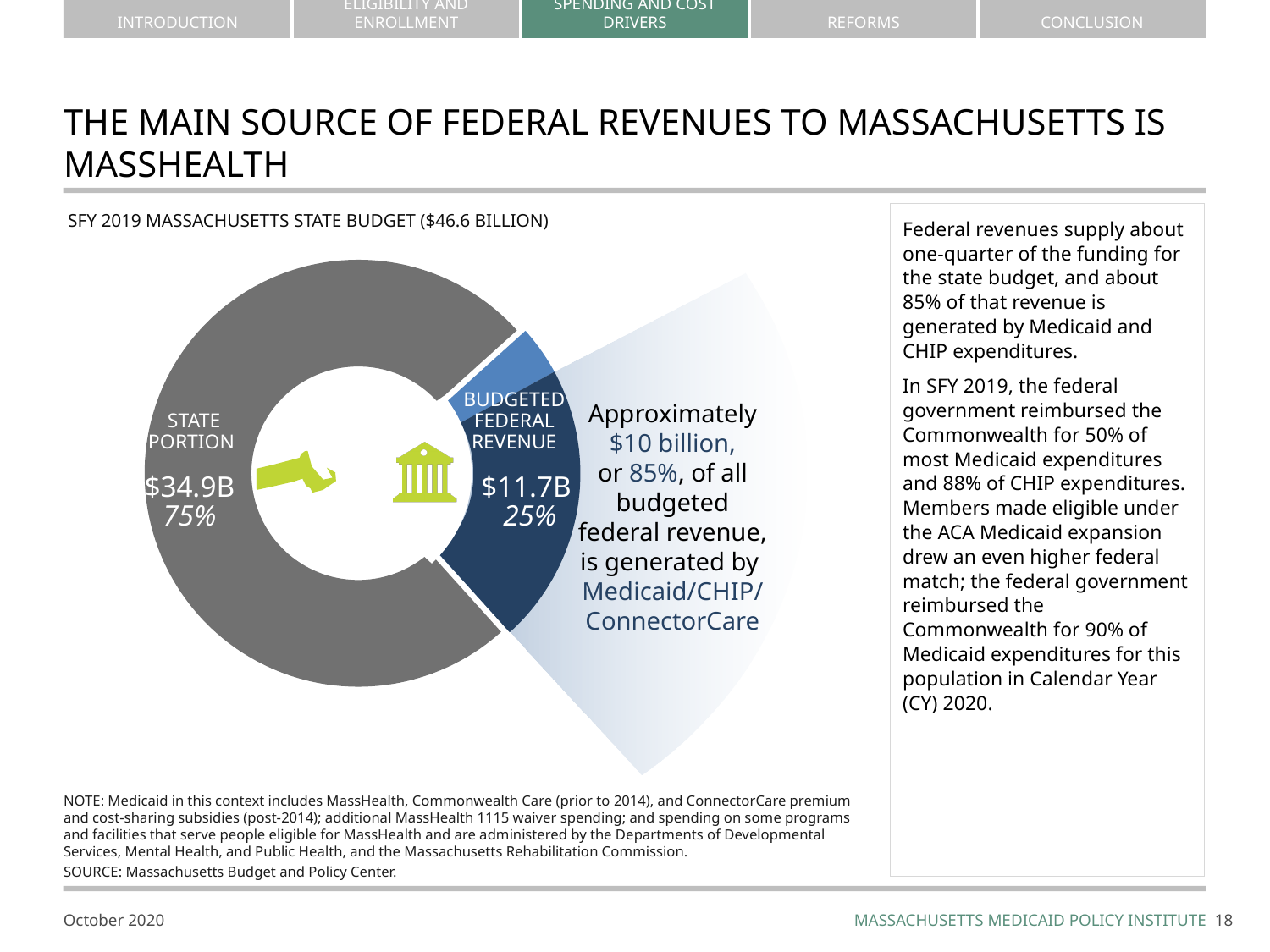
How many slices does the chart have? 3 What share of the state budget is the State Portion? 75% What is the value shown for the State Portion? $34.9B Which slice of the chart is the largest? State Portion Which is larger, the State Portion or Budgeted Federal Revenue? State Portion What share of the state budget is Budgeted Federal Revenue? 25% What fiscal year does the chart's title refer to? SFY 2019 What kind of chart is shown on the slide? Pie (donut) chart What is the value shown for Budgeted Federal Revenue? $11.7B What total budget amount is stated in the chart's title? $46.6 billion What is the difference in dollars between the State Portion and Budgeted Federal Revenue? $23.2B